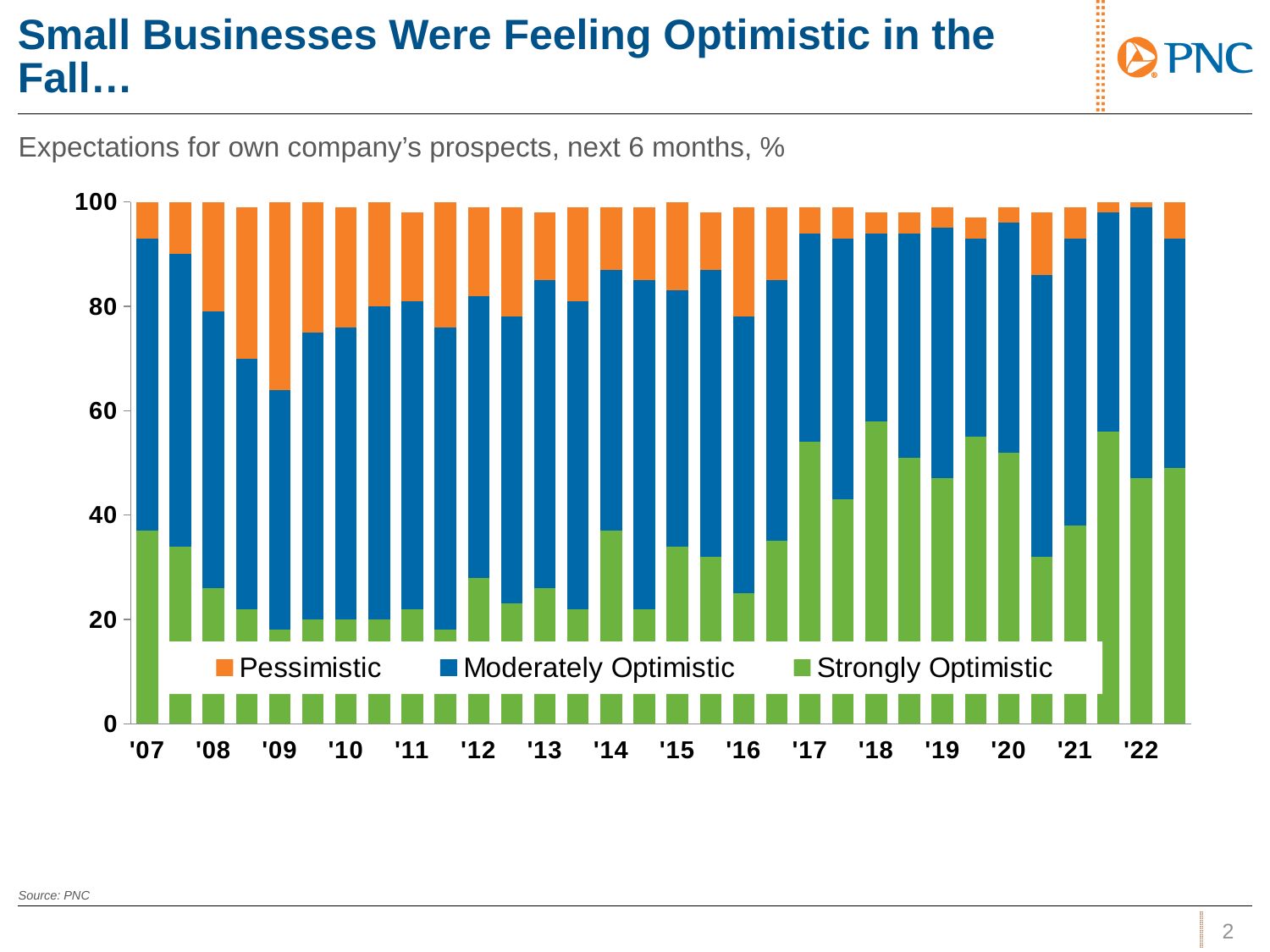
Which has the larger Strongly Optimistic share: the first bar of '18 or the first bar of '09? '18 Is the Strongly Optimistic value for the first bar of '09 greater or less than 20? less What is the subtitle describing the chart's measure? Expectations for own company's prospects, next 6 months, % How many series does the legend list? 3 What kind of chart is shown on the slide? Stacked bar chart Which series is shown in orange? Pessimistic Is the Strongly Optimistic value for the first bar of '18 greater or less than 40? greater Is the Strongly Optimistic value for the first bar of '08 greater or less than 20? greater How many year labels appear on the x axis? 16 Does the Strongly Optimistic share rise or fall from '07 to '09? Fall